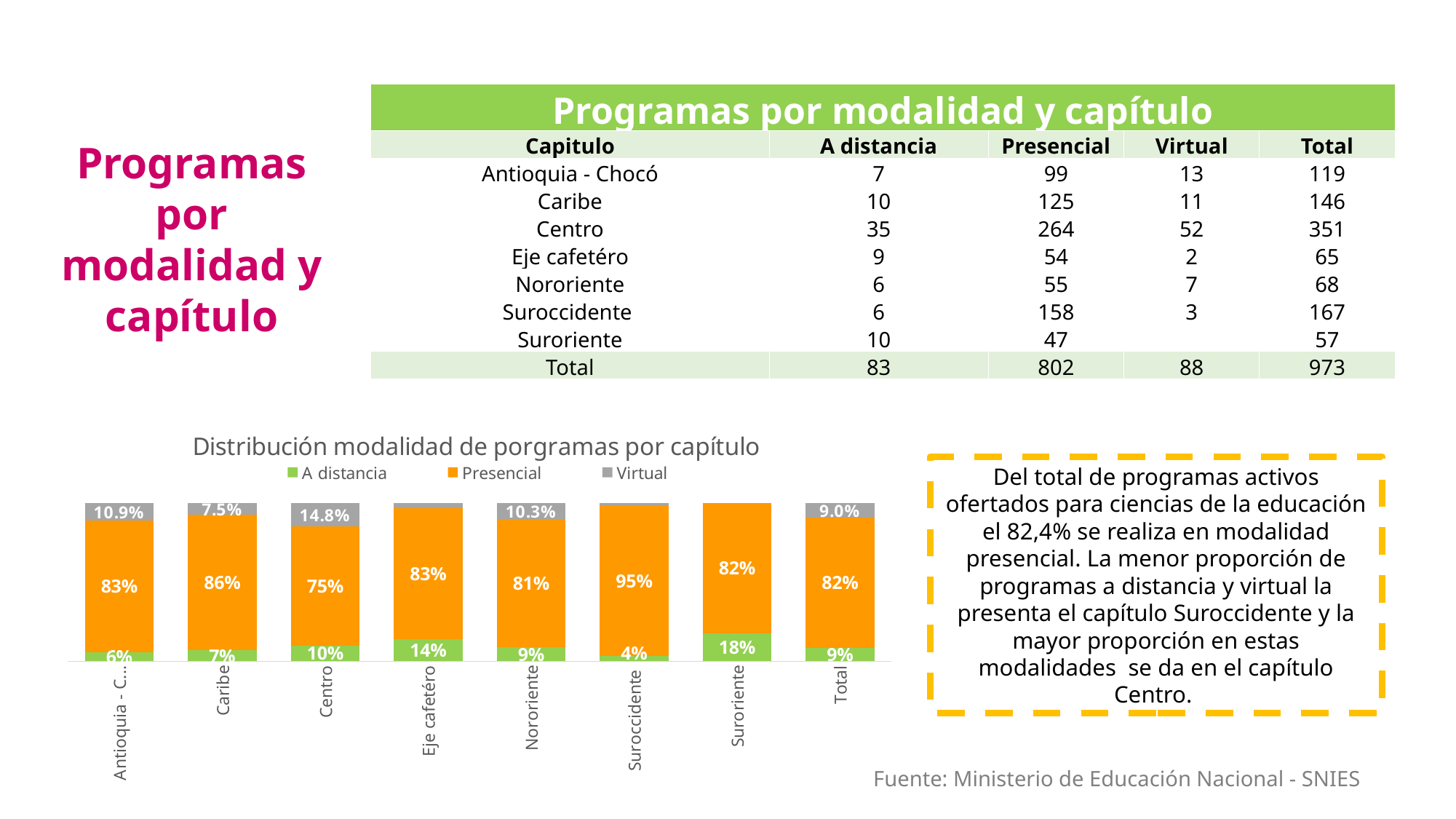
How many categories are shown along the x axis of the chart? 8 What is the title of the chart? Distribución modalidad de porgramas por capítulo What is the Presencial value for Suroccidente in the chart? 95% Which category has the highest Presencial value in the chart? Suroccidente What is the difference between the Presencial values for Caribe and Centro in the chart? 11% Which is larger in the chart, the A distancia value for Eje cafetéro or for Nororiente? Eje cafetéro How many series does the legend of the chart list? 3 What kind of chart is shown on the slide? Stacked bar chart What is the Presencial value for Total in the chart? 82% What is the Virtual value for Centro in the chart? 14.8% Which category has the lowest A distancia value in the chart? Suroccidente What is the A distancia value for Suroriente in the chart? 18%